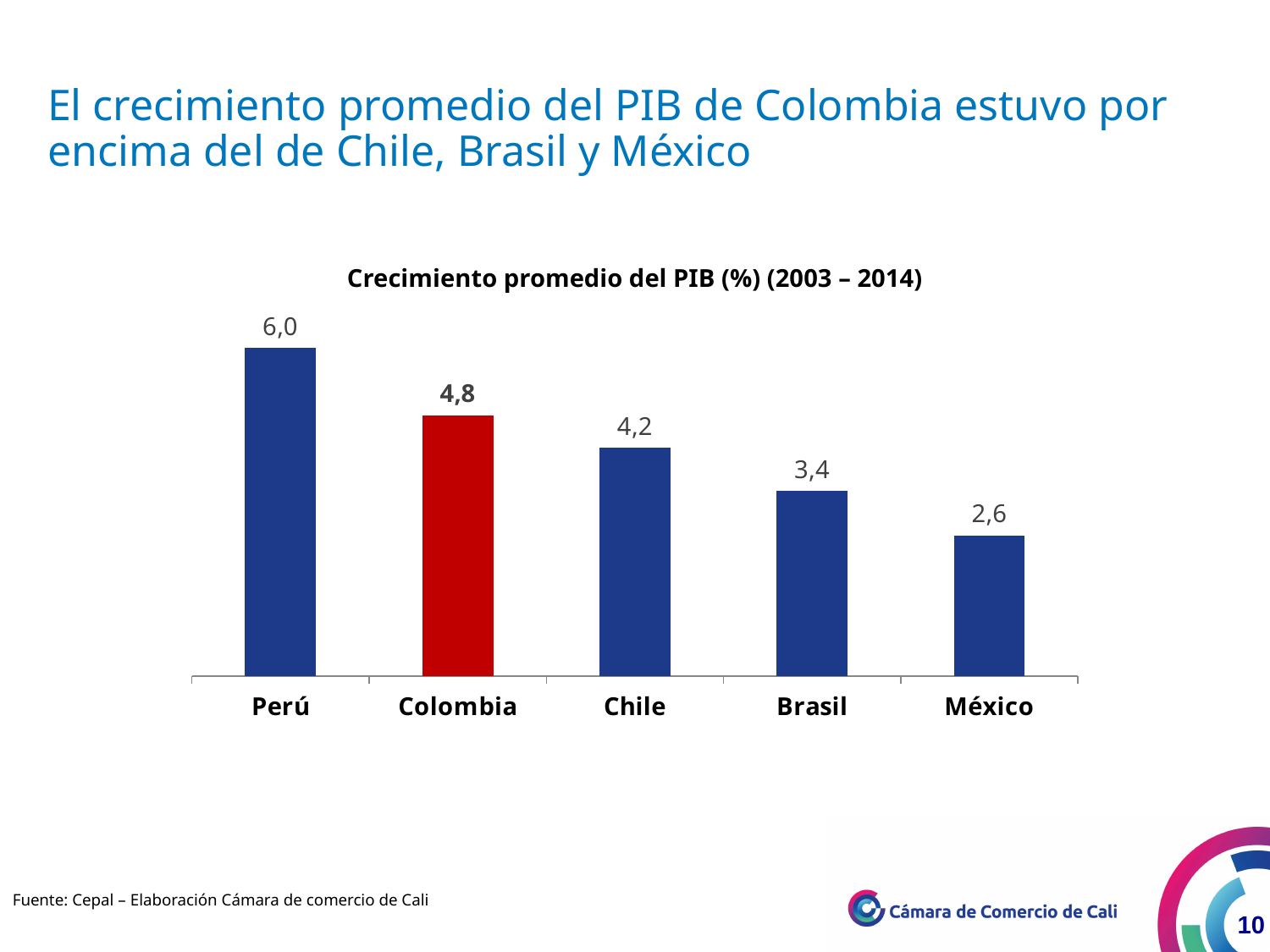
Which country has the lowest average GDP growth in the chart? México Do the values rise or fall from left to right across the chart? Fall Which has a higher value, Colombia or Chile? Colombia What kind of chart is shown on the slide? Bar chart What is the value shown for México? 2,6 How many countries are shown in the chart? 5 Which country's bar is coloured red in the chart? Colombia What is the average GDP growth value shown for Colombia? 4,8 What is the difference between the values for Perú and Colombia? 1,2 What is the value shown for Perú? 6,0 What is the difference between the values for Chile and Brasil? 0,8 Which country has the highest average GDP growth in the chart? Perú